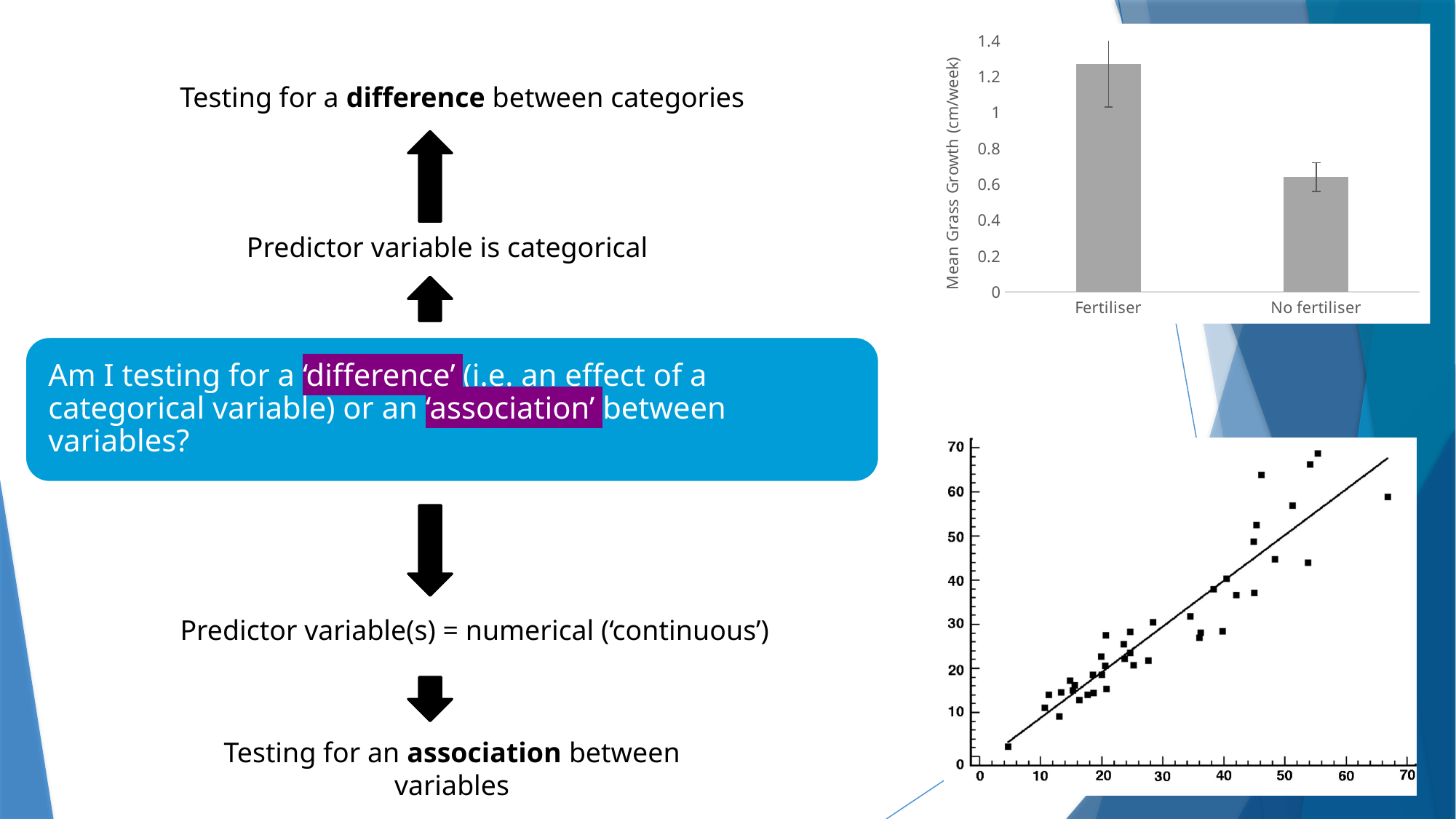
In the top-right bar chart, which is larger: the value for Fertiliser or the value for No fertiliser? Fertiliser In the top-right bar chart, which category has the highest mean grass growth? Fertiliser In the bottom-right scatter plot, what is the highest value shown on the x axis? 70 In the top-right bar chart, is the value for No fertiliser greater or less than 0.8? less In the top-right bar chart, how many categories are shown on the x axis? 2 In the top-right bar chart, is the value for Fertiliser greater or less than 1? greater In the bottom-right scatter plot, do the y values generally rise or fall as x increases? rise What kind of chart is the top-right chart on the slide? bar chart In the top-right bar chart, which category has the lowest mean grass growth? No fertiliser What kind of chart is the bottom-right chart on the slide? scatter plot What is the y-axis title of the top-right bar chart? Mean Grass Growth (cm/week)